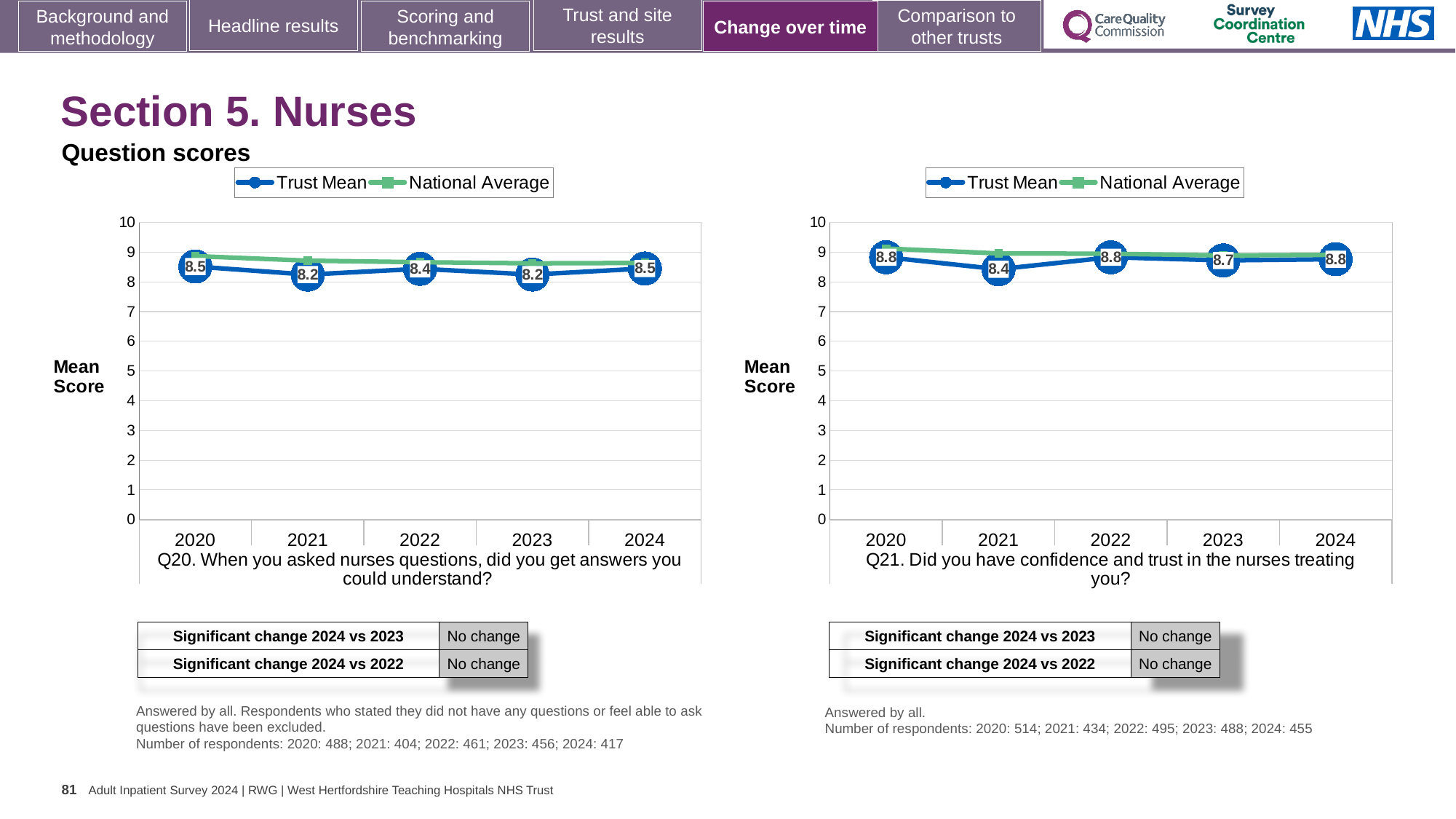
How many years are plotted on the Q21 chart? 5 On the Q20 chart, is the Trust Mean score for 2022 higher or lower than the Trust Mean score for 2021? higher On the Q21 chart, what is the difference between the Trust Mean scores for 2020 and 2021? 0.4 On the Q20 chart, what is the difference between the Trust Mean scores for 2024 and 2023? 0.3 What type of chart is used for Q21? line chart On the Q21 chart, what is the Trust Mean score for 2023? 8.7 How many series does the legend of the Q20 chart list? 2 On the Q21 chart, what is the Trust Mean score for 2021? 8.4 On the Q21 chart, which year has the lowest Trust Mean score? 2021 On the Q20 chart, what is the Trust Mean score for 2021? 8.2 On the Q20 chart, is the National Average for 2020 greater or less than 8? greater On the Q20 chart, what is the Trust Mean score for 2024? 8.5